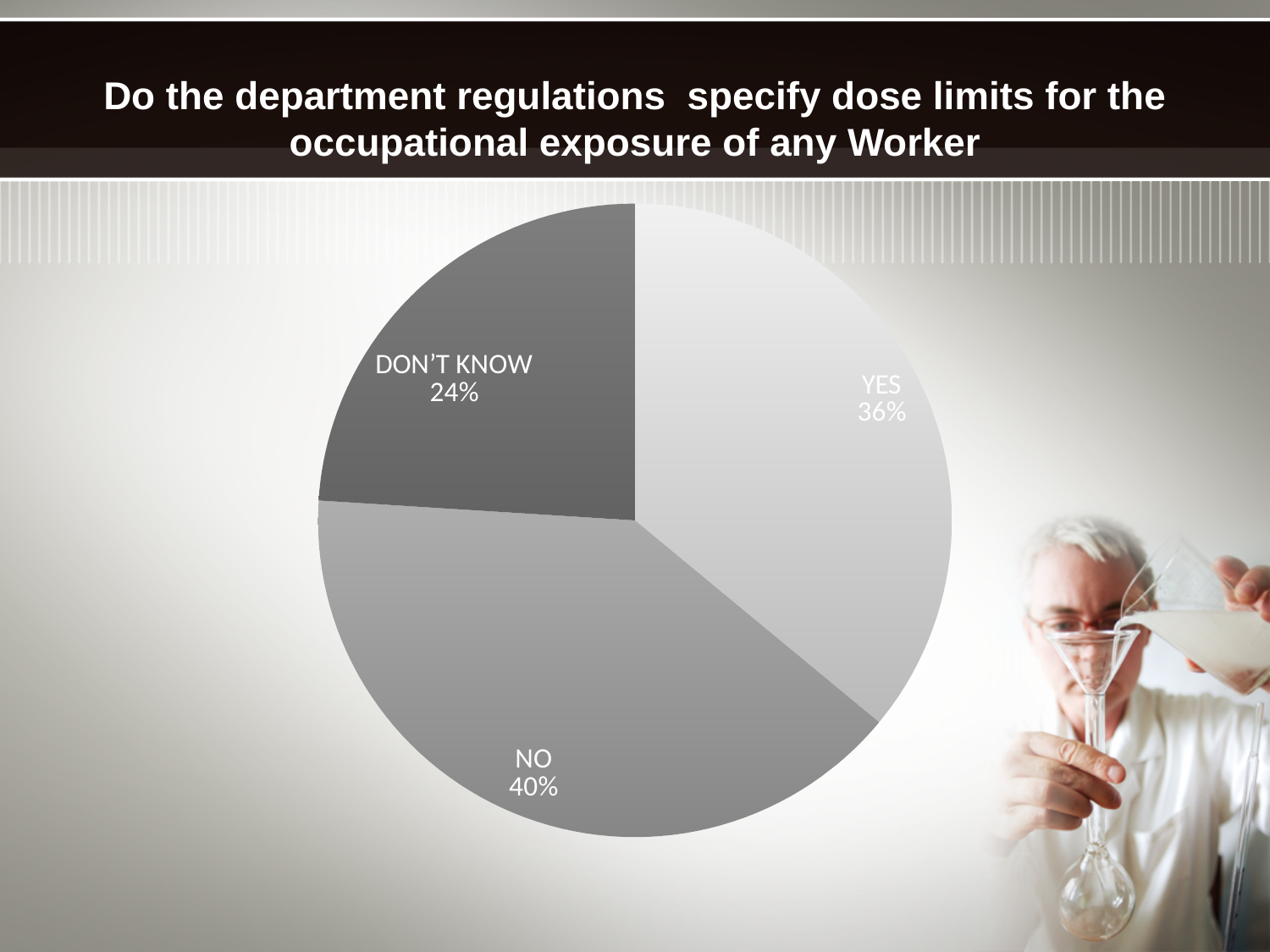
How many slices does the pie chart have? 3 Which is larger, the YES slice or the DON'T KNOW slice? YES What is the title of the slide containing the chart? Do the department regulations specify dose limits for the occupational exposure of any Worker What percentage of responses were YES? 36% What kind of chart is shown on the slide? Pie chart What percentage of responses were DON'T KNOW? 24% What percentage of responses were NO? 40% Which slice of the pie is the darkest in colour? DON'T KNOW Which response has the smallest share of the pie? DON'T KNOW Which response has the largest share of the pie? NO What is the difference in percentage points between the YES and DON'T KNOW slices? 12 What is the difference in percentage points between the NO and YES slices? 4